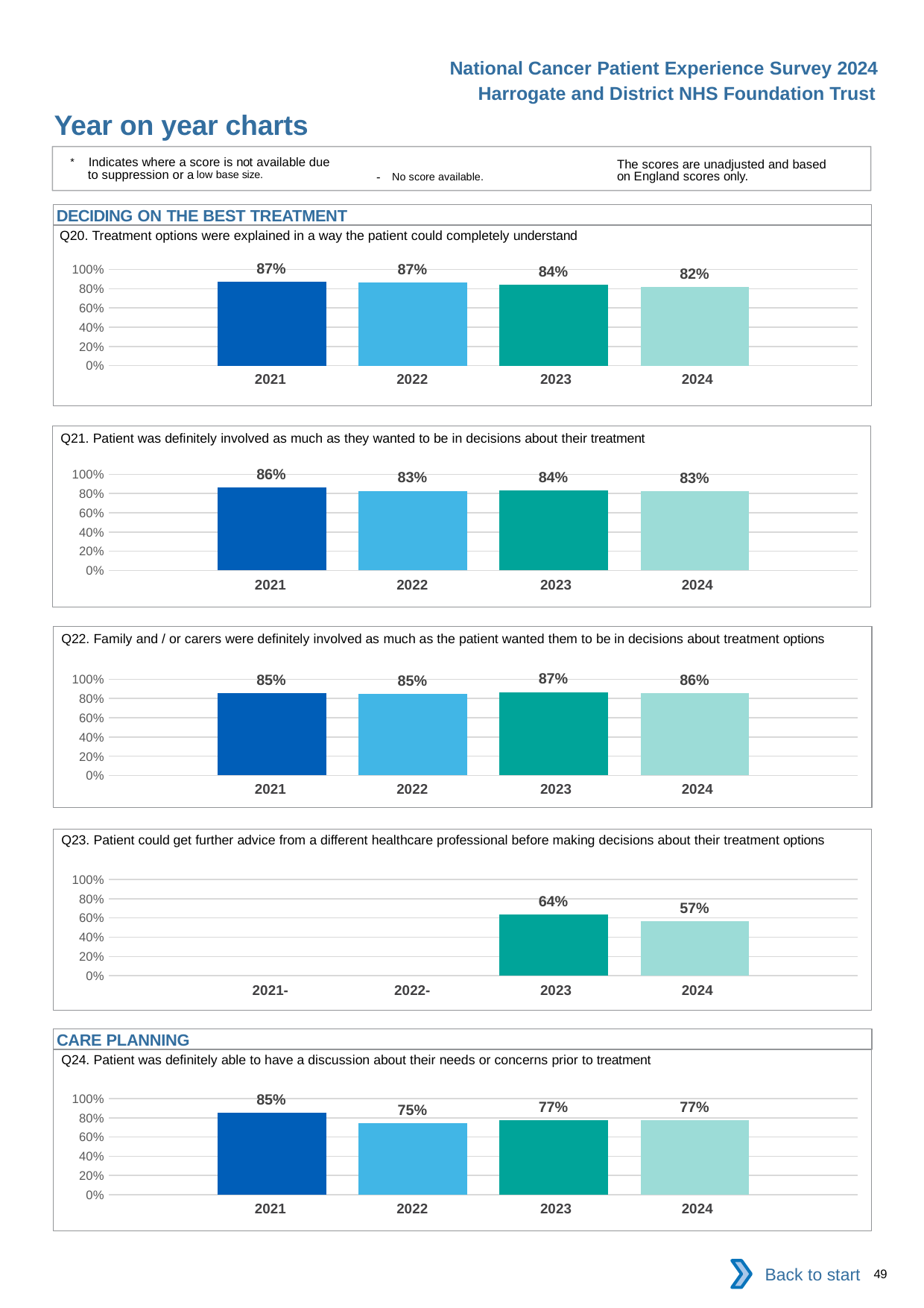
In the Q22 chart, which year has the highest value? 2023 In the Q23 chart, is the value for 2024 greater or less than 60%? less In the Q24 chart, which is larger, the value for 2021 or the value for 2023? 2021 In the Q20 chart, what is the difference between the 2021 and 2024 values? 5 percentage points In the Q21 chart, what is the value for 2023? 84% In the Q23 chart, what is the difference between the 2023 and 2024 values? 7 percentage points In the Q21 chart, which year has the highest value? 2021 In the Q20 chart, what is the value for 2024? 82% In the Q22 chart, what is the value for 2022? 85% What kind of chart is the Q24 chart? Bar chart In the Q24 chart, which year has the lowest value? 2022 In the Q23 chart, how many years have a bar plotted? 2